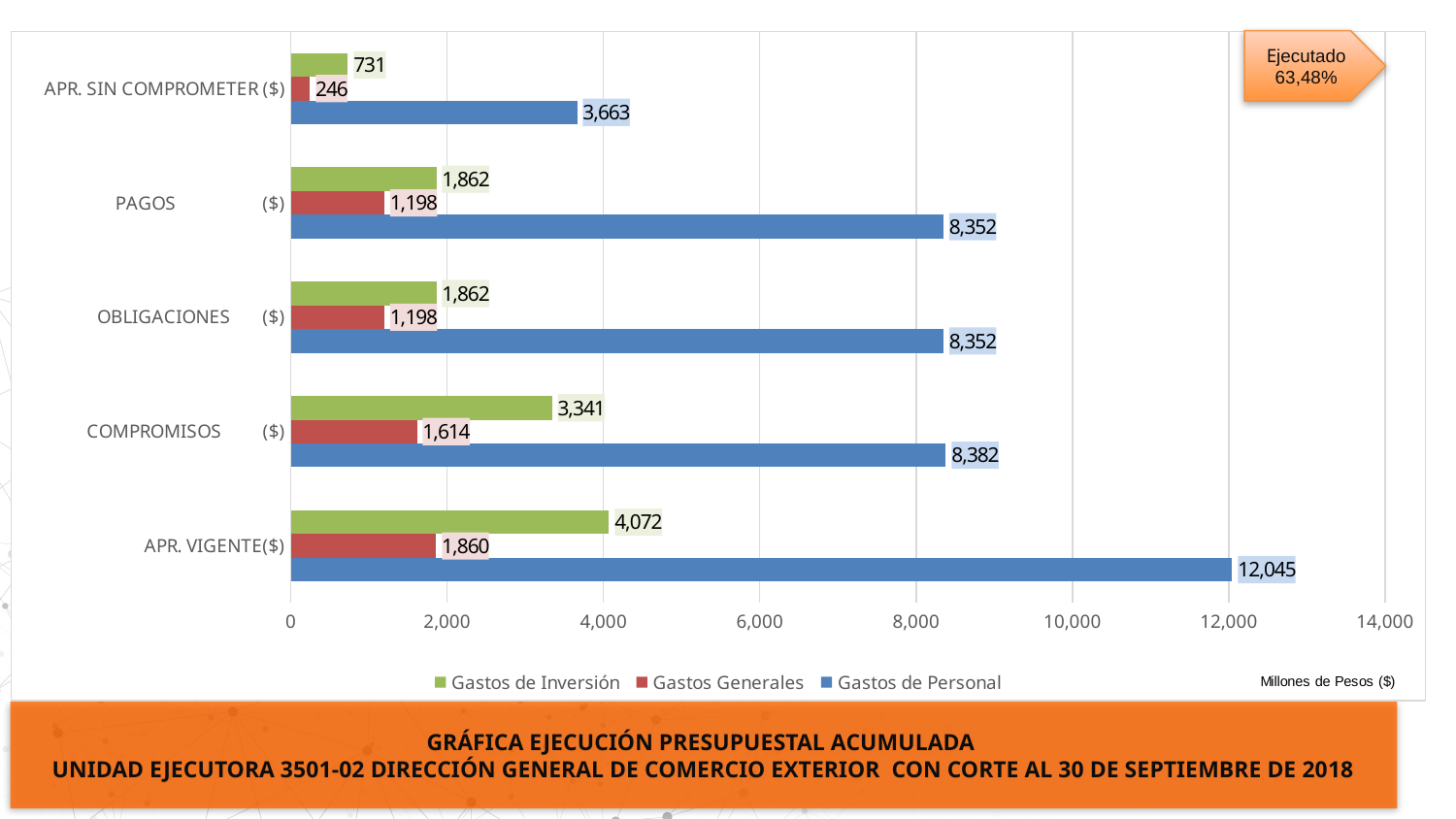
How many categories are shown on the y axis? 5 How many series does the legend list? 3 What is the value of Gastos de Personal for APR. VIGENTE($)? 12,045 What is the total of the three series for APR. SIN COMPROMETER ($)? 4,640 What is the value of Gastos de Inversión for COMPROMISOS ($)? 3,341 Which is larger: Gastos de Inversión for APR. VIGENTE($) or Gastos de Inversión for PAGOS ($)? APR. VIGENTE($) What percentage is shown in the 'Ejecutado' callout on the chart? 63,48% What is the value of Gastos Generales for APR. SIN COMPROMETER ($)? 246 Which category has the lowest Gastos de Inversión value? APR. SIN COMPROMETER ($) Which category has the highest Gastos de Personal value? APR. VIGENTE($) What is the difference between Gastos de Personal for APR. VIGENTE($) and for COMPROMISOS ($)? 3,663 What kind of chart is shown on the slide? Bar chart